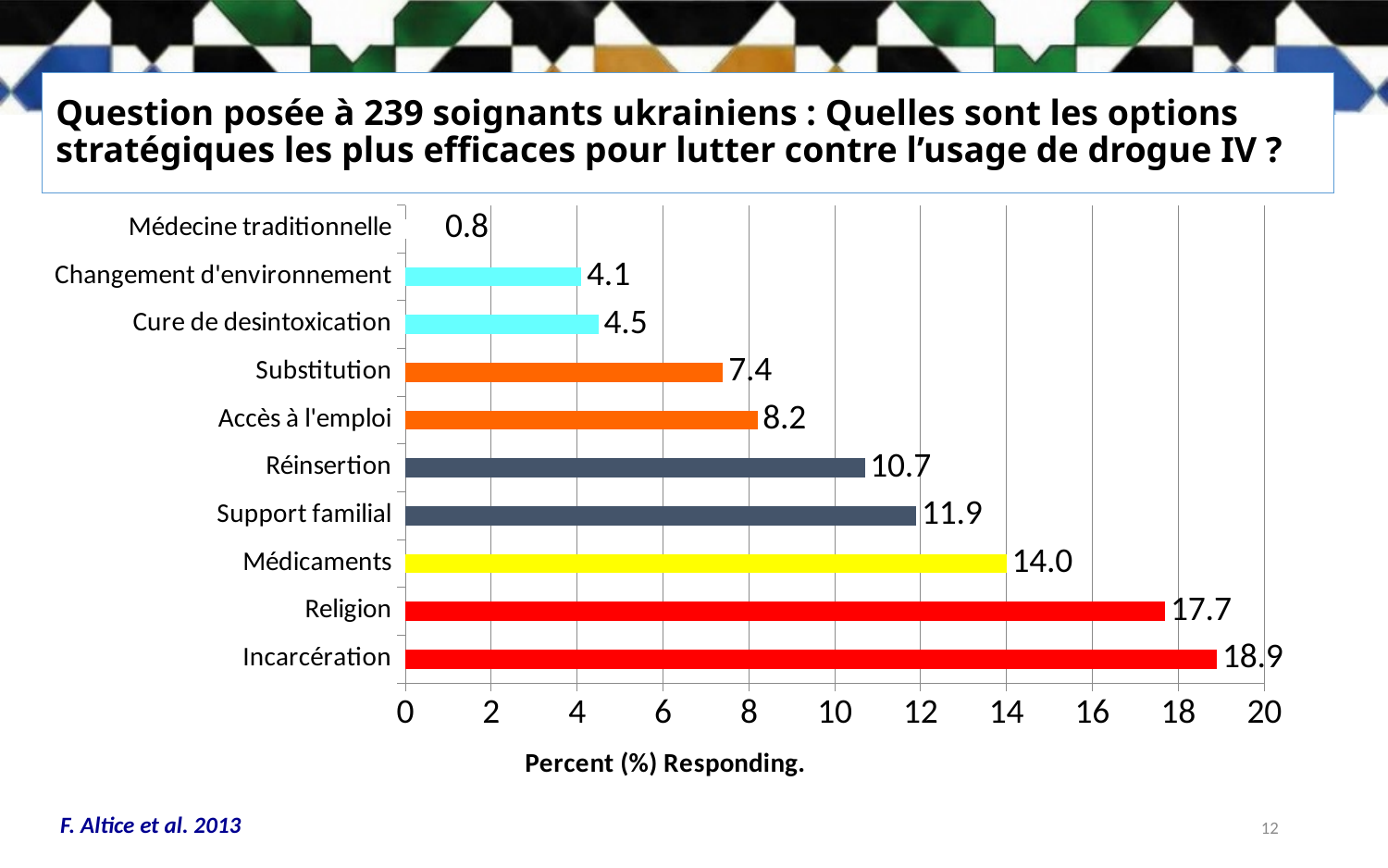
How many categories are shown in the chart? 10 What is the difference between the values for Support familial and Réinsertion? 1.2 What kind of chart is shown on the slide? Bar chart What is the value for Cure de desintoxication? 4.5 What is the difference between the values for Incarcération and Religion? 1.2 Is the value for Religion greater or less than 16? greater What is the label of the horizontal axis? Percent (%) Responding. Which category has the highest value? Incarcération Which category has the lowest value? Médecine traditionnelle What is the value for Incarcération? 18.9 What is the value for Médicaments? 14.0 Which is larger, the value for Substitution or the value for Accès à l'emploi? Accès à l'emploi